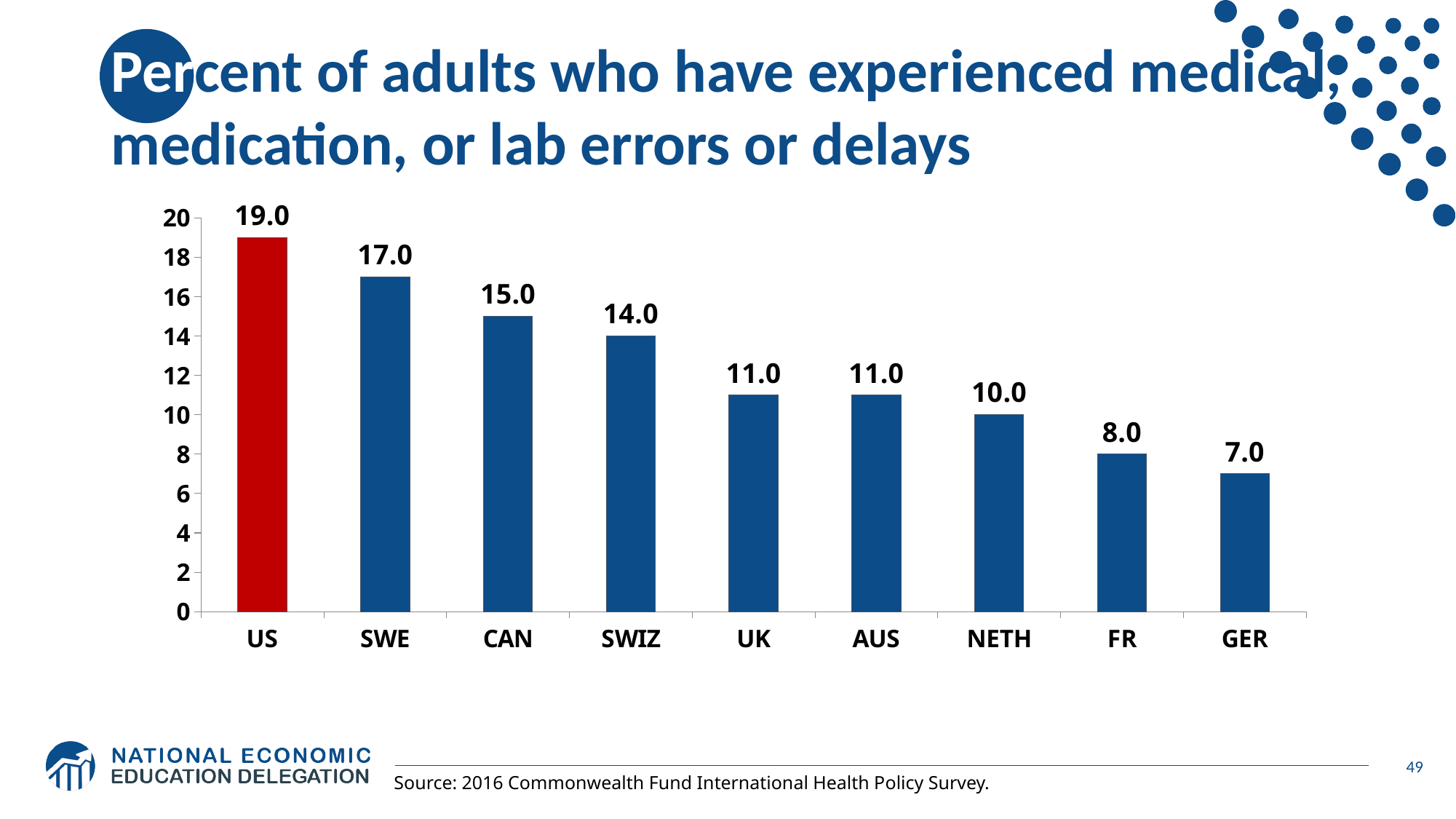
Is the value for CAN greater or less than 10? greater Which country has the lowest value? GER How many countries are shown on the chart? 9 What is the value for SWIZ? 14.0 What is the value for the US? 19.0 What is the value for NETH? 10.0 Which country has the highest value? US Which is larger, the value for FR or the value for NETH? NETH What kind of chart is shown on the slide? bar chart Which bar is coloured red rather than blue? US What is the difference between the values for SWE and CAN? 2.0 What is the difference between the values for the US and GER? 12.0